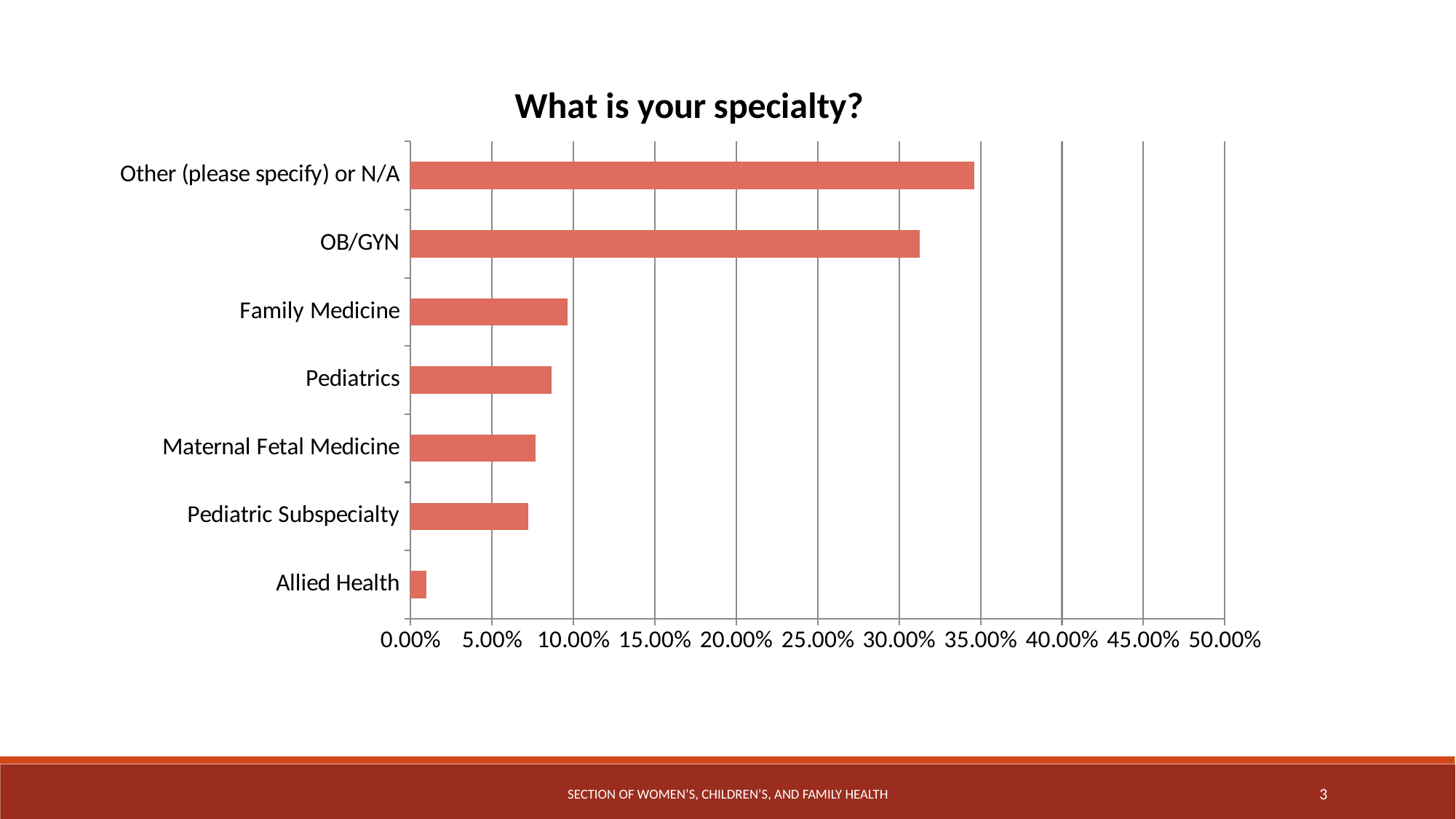
Is the value for OB/GYN greater or less than 30.00%? greater Which has a larger value, OB/GYN or Family Medicine? OB/GYN What is the title of the chart? What is your specialty? Which specialty category has the lowest value? Allied Health Is the value for Allied Health greater or less than 5.00%? less Which specialty category has the highest value? Other (please specify) or N/A Which has a larger value, Pediatrics or Pediatric Subspecialty? Pediatrics How many specialty categories are shown in the chart? 7 Which has a larger value, Other (please specify) or N/A or OB/GYN? Other (please specify) or N/A What kind of chart is shown on the slide? bar chart